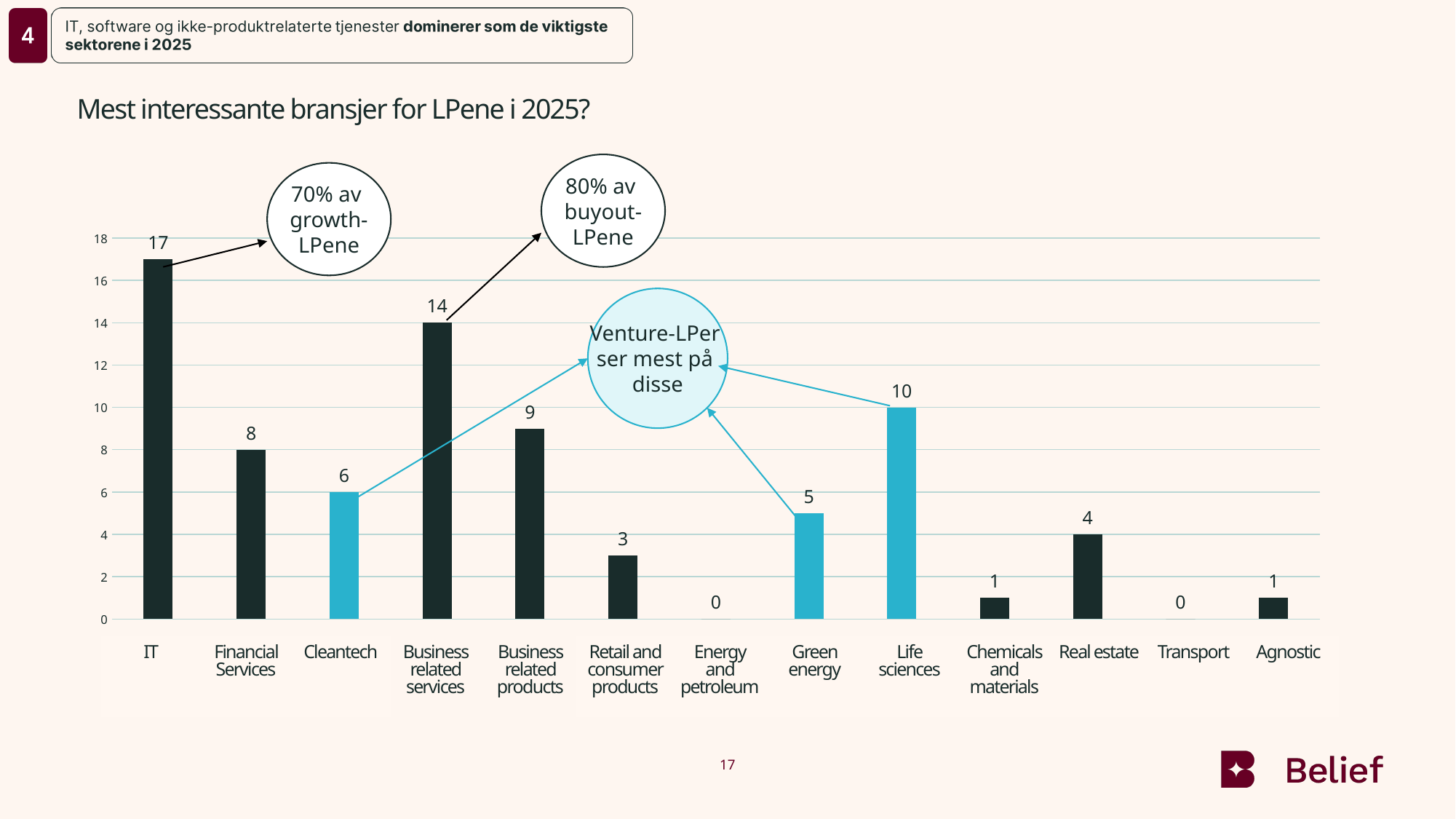
Which category has the highest value? IT What kind of chart is this? Bar chart Which categories have a value of 0? Energy and petroleum, Transport What is the difference between the values for IT and Financial Services? 9 What is the value for IT? 17 Which categories are shown with light blue bars? Cleantech, Green energy, Life sciences What is the title of the chart? Mest interessante bransjer for LPene i 2025? Which is larger, the value for Cleantech or the value for Real estate? Cleantech What is the value for Green energy? 5 How many categories are shown on the x axis? 13 What is the value for Business related services? 14 What is the value for Life sciences? 10